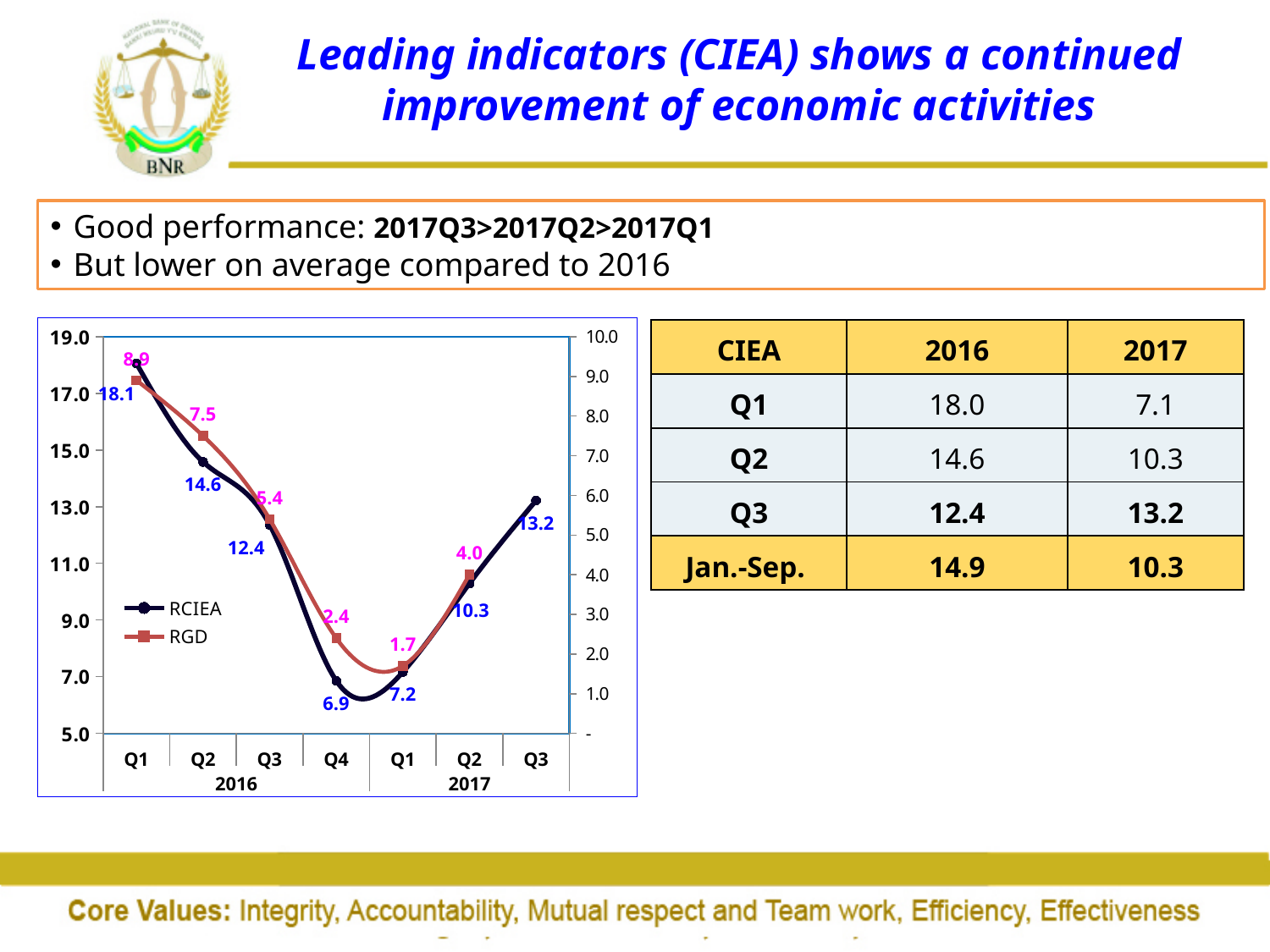
In which quarter is the RCIEA value lowest? Q4 2016 Does the RCIEA series rise or fall from Q1 2016 to Q4 2016? fall What is the difference between the RCIEA values for Q1 2016 and Q4 2016? 11.2 What type of chart is shown on the slide? line chart Which is larger, the RCIEA value for Q2 2017 or for Q3 2017? Q3 2017 In which quarter is the RGD value highest? Q1 2016 How many quarters are plotted on the x axis of the chart? 7 What is the RCIEA value for Q3 2017 in the chart? 13.2 How many series does the chart legend list? 2 What is the RGD value for Q2 2016 in the chart? 7.5 What is the RCIEA value for Q1 2016 in the chart? 18.1 What is the RGD value for Q1 2017 in the chart? 1.7